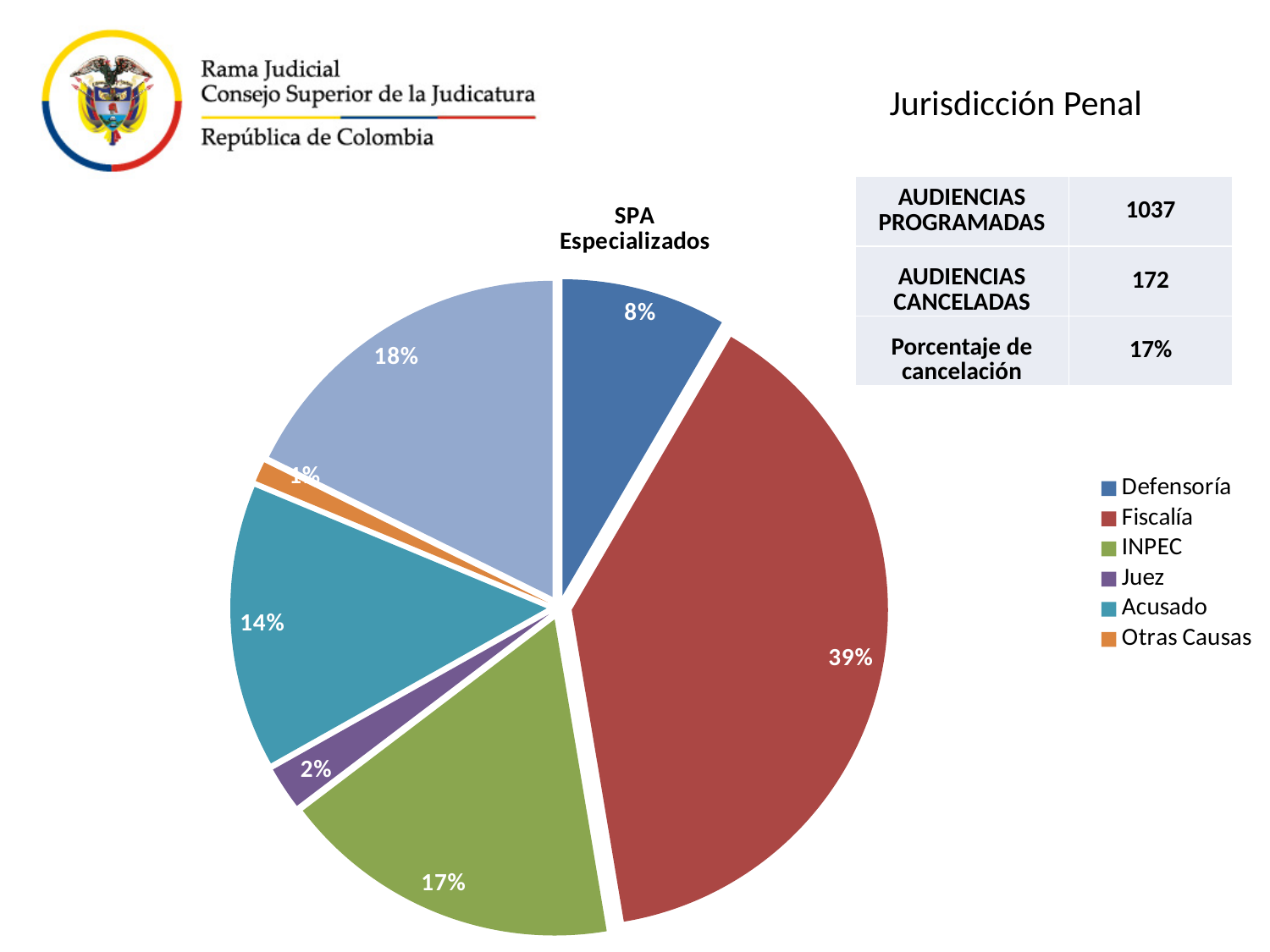
Which legend category has the largest slice of the pie? Fiscalía Which legend category has the smallest slice of the pie? Otras Causas What share of the pie does Juez represent? 2% How many entries does the legend list? 6 What is the title of the pie chart? SPA Especializados What share of the pie does Otras Causas represent? 1% What is the difference in percentage points between the Fiscalía slice and the INPEC slice? 22 What kind of chart is shown on the slide? pie chart What share of the pie does Defensoría represent? 8%